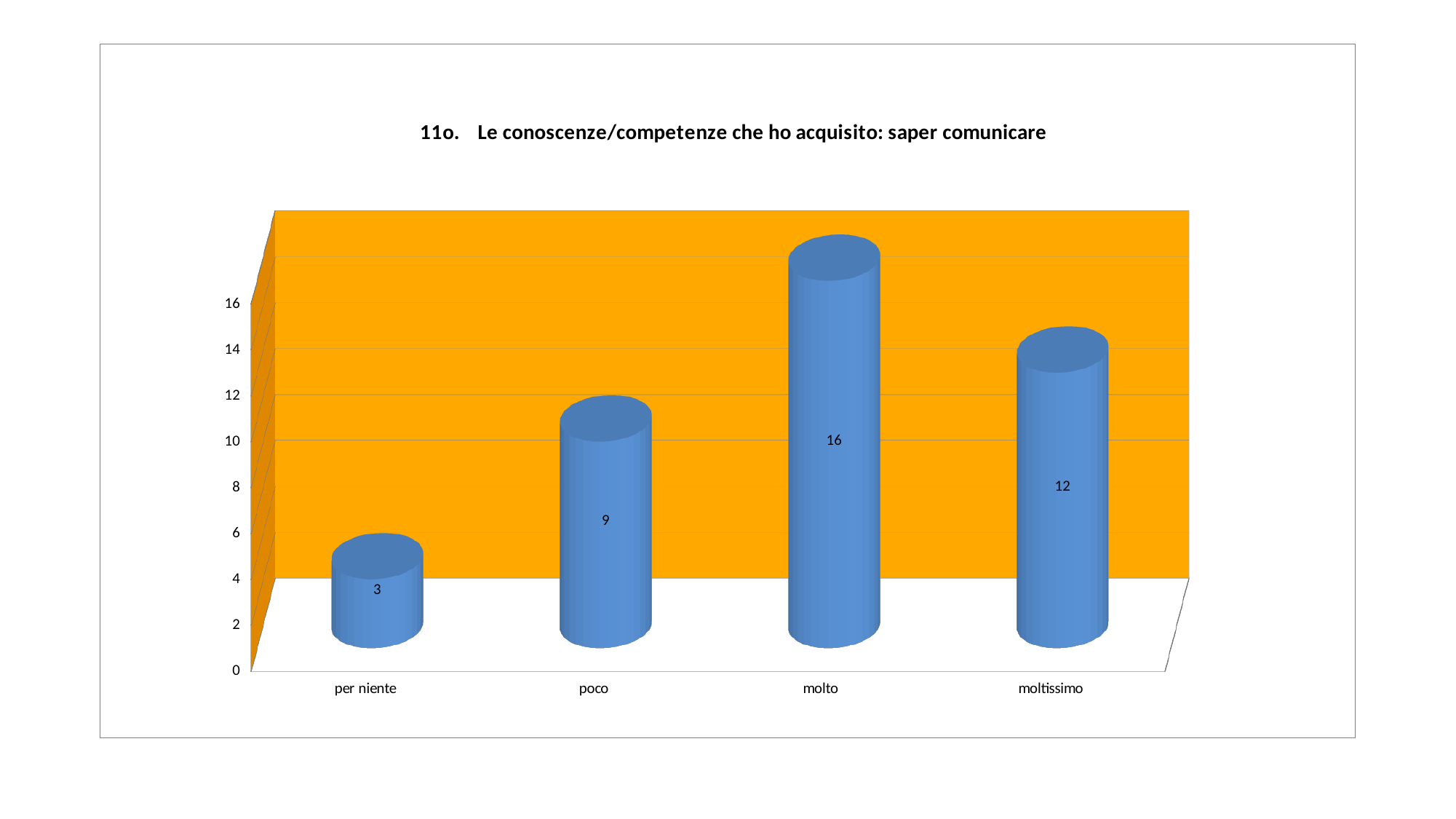
Which category has the lowest value? per niente What is the value for "poco"? 9 What is the value for "moltissimo"? 12 What is the difference between the values for "molto" and "moltissimo"? 4 What is the value for "molto"? 16 What is the title of the chart? 11o. Le conoscenze/competenze che ho acquisito: saper comunicare Which is larger, the value for "poco" or the value for "moltissimo"? moltissimo What kind of chart is shown on the slide? bar chart Which category has the highest value? molto What is the difference between the values for "poco" and "per niente"? 6 What is the value for "per niente"? 3 How many categories are shown on the x axis? 4